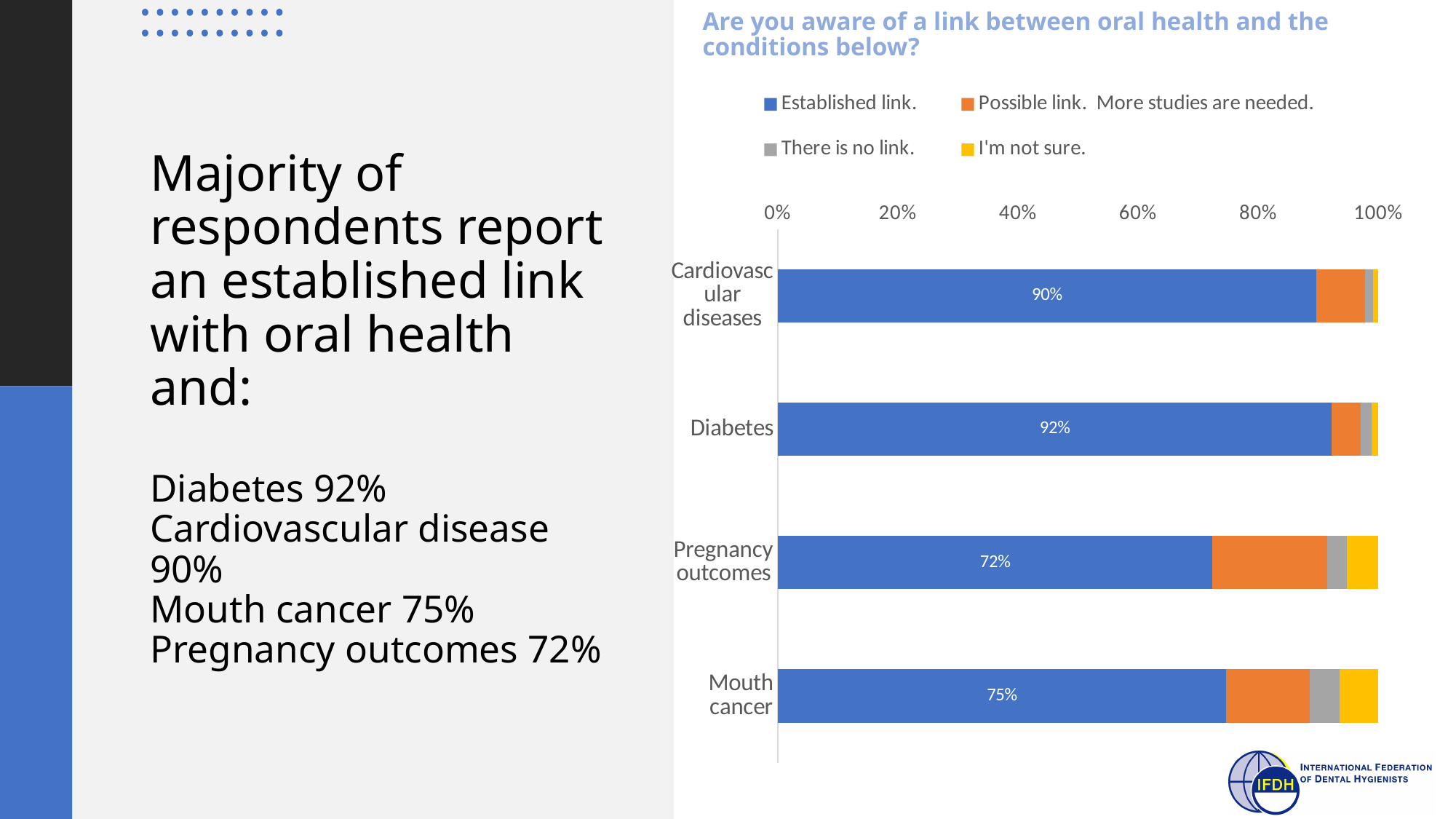
What is the 'Established link' value for Pregnancy outcomes? 72% Which condition has the highest 'Established link' percentage? Diabetes How many series does the legend list? 4 Which has a larger 'Established link' value, Mouth cancer or Cardiovascular diseases? Cardiovascular diseases What percentage of respondents report an established link between oral health and diabetes? 92% What kind of chart is shown on the slide? Stacked bar chart Which colour represents 'I'm not sure.' in the chart? Yellow Which condition has the lowest 'Established link' percentage? Pregnancy outcomes What is the 'Established link' value for Cardiovascular diseases? 90% What is the difference between the 'Established link' values for Diabetes and Pregnancy outcomes? 20% How many conditions are shown on the chart? 4 What is the 'Established link' value for Mouth cancer? 75%